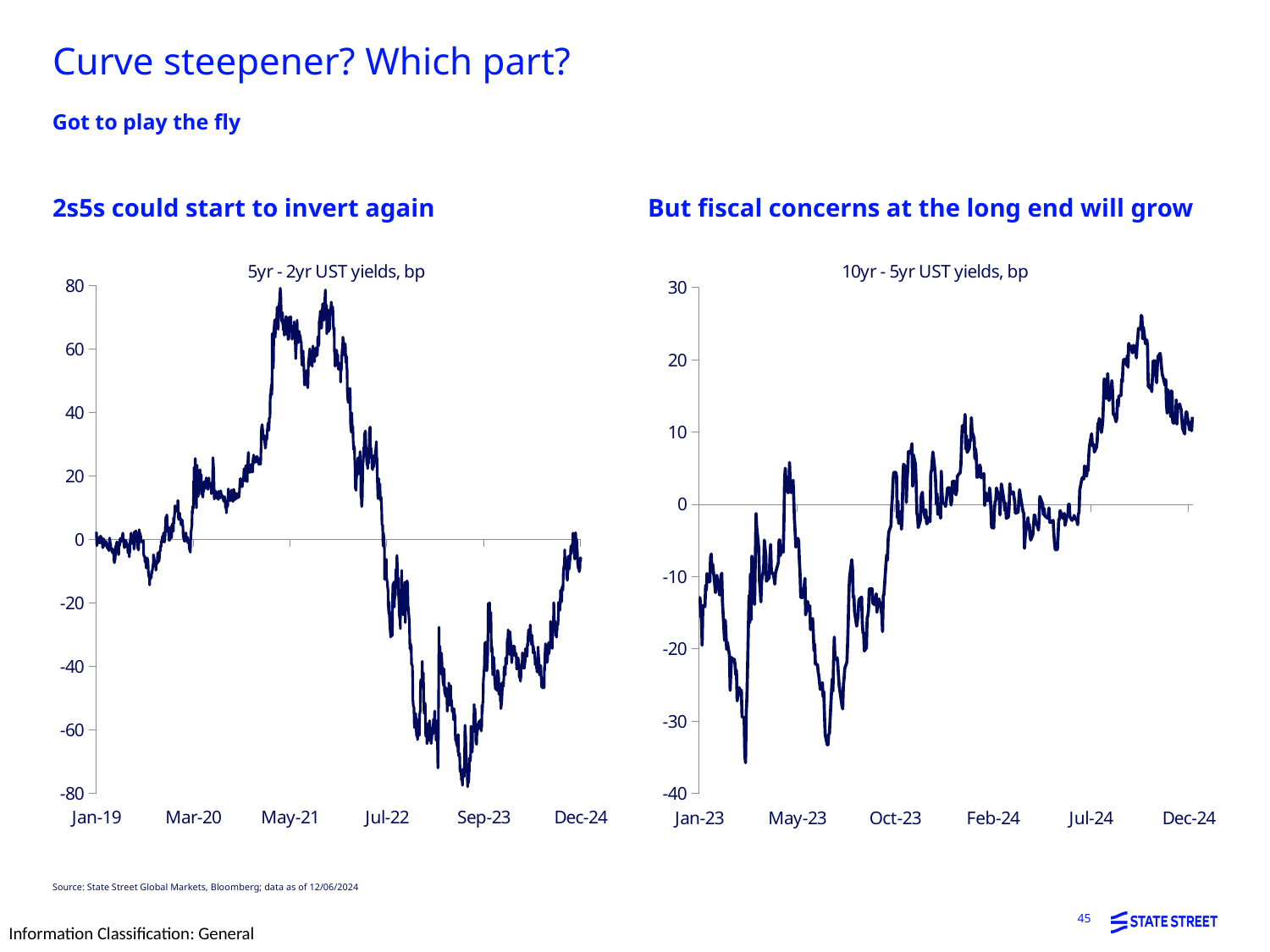
What kind of chart is the right chart titled '10yr - 5yr UST yields, bp'? line chart What is the title of the right chart? 10yr - 5yr UST yields, bp In the left chart (5yr - 2yr UST yields), is the lowest value around Sep-23 greater or less than -60? less In the right chart (10yr - 5yr UST yields), is the lowest value in early 2023 greater or less than -30? less What kind of chart is the left chart titled '5yr - 2yr UST yields, bp'? line chart In the left chart (5yr - 2yr UST yields), is the value at Dec-24 greater or less than 0? less In the right chart (10yr - 5yr UST yields), does the line generally rise or fall between Jul-24 and Dec-24? rise In the left chart (5yr - 2yr UST yields), does the line generally rise or fall between May-21 and Sep-23? fall What is the title of the left chart? 5yr - 2yr UST yields, bp